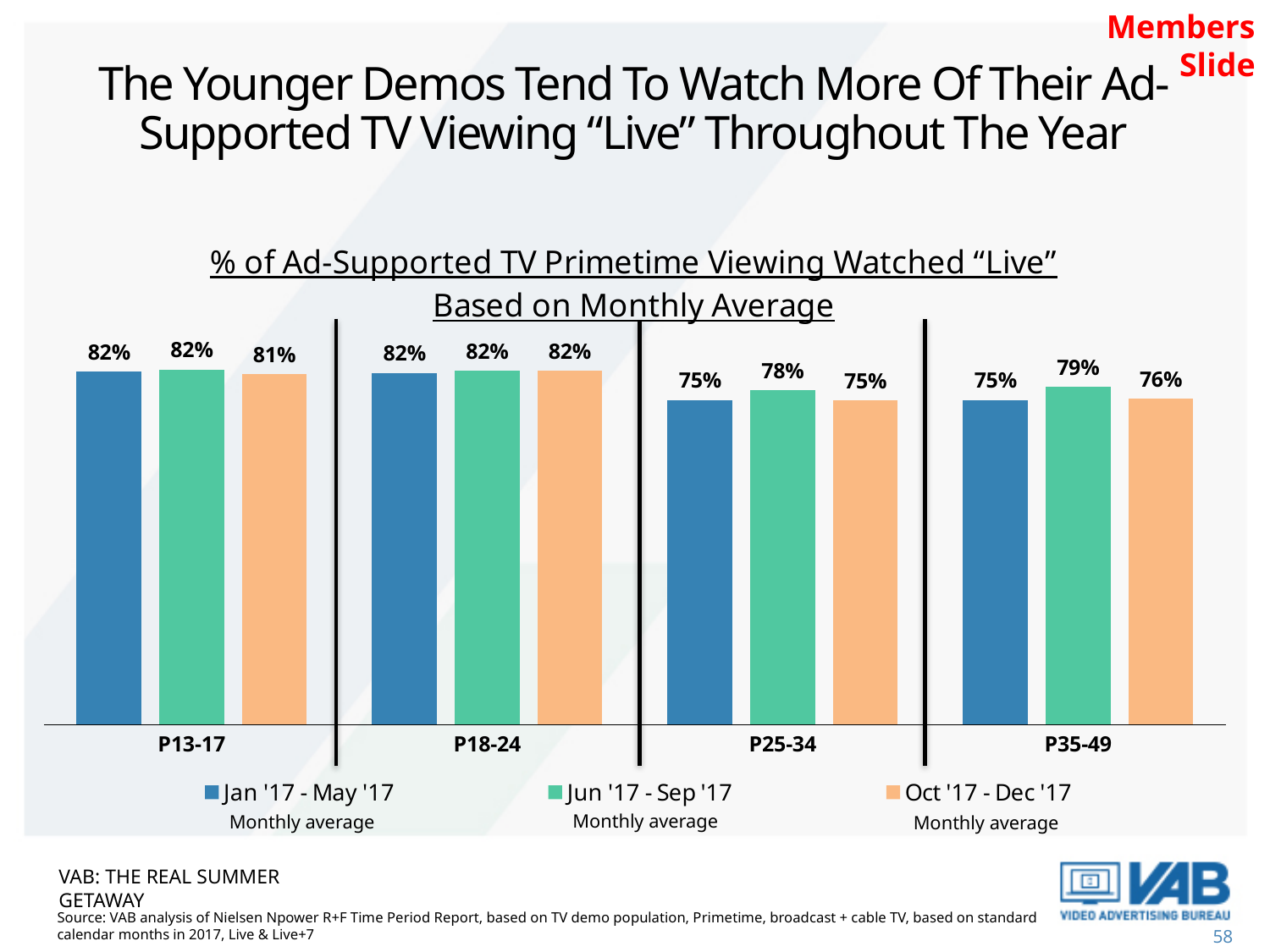
Do the Jan '17 - May '17 values rise or fall from P13-17 to P35-49? Fall Which is larger: the Jun '17 - Sep '17 value for P35-49 or the Oct '17 - Dec '17 value for P35-49? Jun '17 - Sep '17 What is the value for P18-24 in the Oct '17 - Dec '17 series? 82% What is the title of the chart? % of Ad-Supported TV Primetime Viewing Watched "Live" Based on Monthly Average What is the value for P25-34 in the Jun '17 - Sep '17 series? 78% What is the value for P13-17 in the Jan '17 - May '17 series? 82% What is the difference between the Jun '17 - Sep '17 values for P18-24 and P25-34? 4% What is the value for P35-49 in the Oct '17 - Dec '17 series? 76% How many series does the legend list? 3 How many demo categories are shown on the x axis? 4 What kind of chart is shown on the slide? Bar chart Which demo has the lowest value in the Jun '17 - Sep '17 series? P25-34